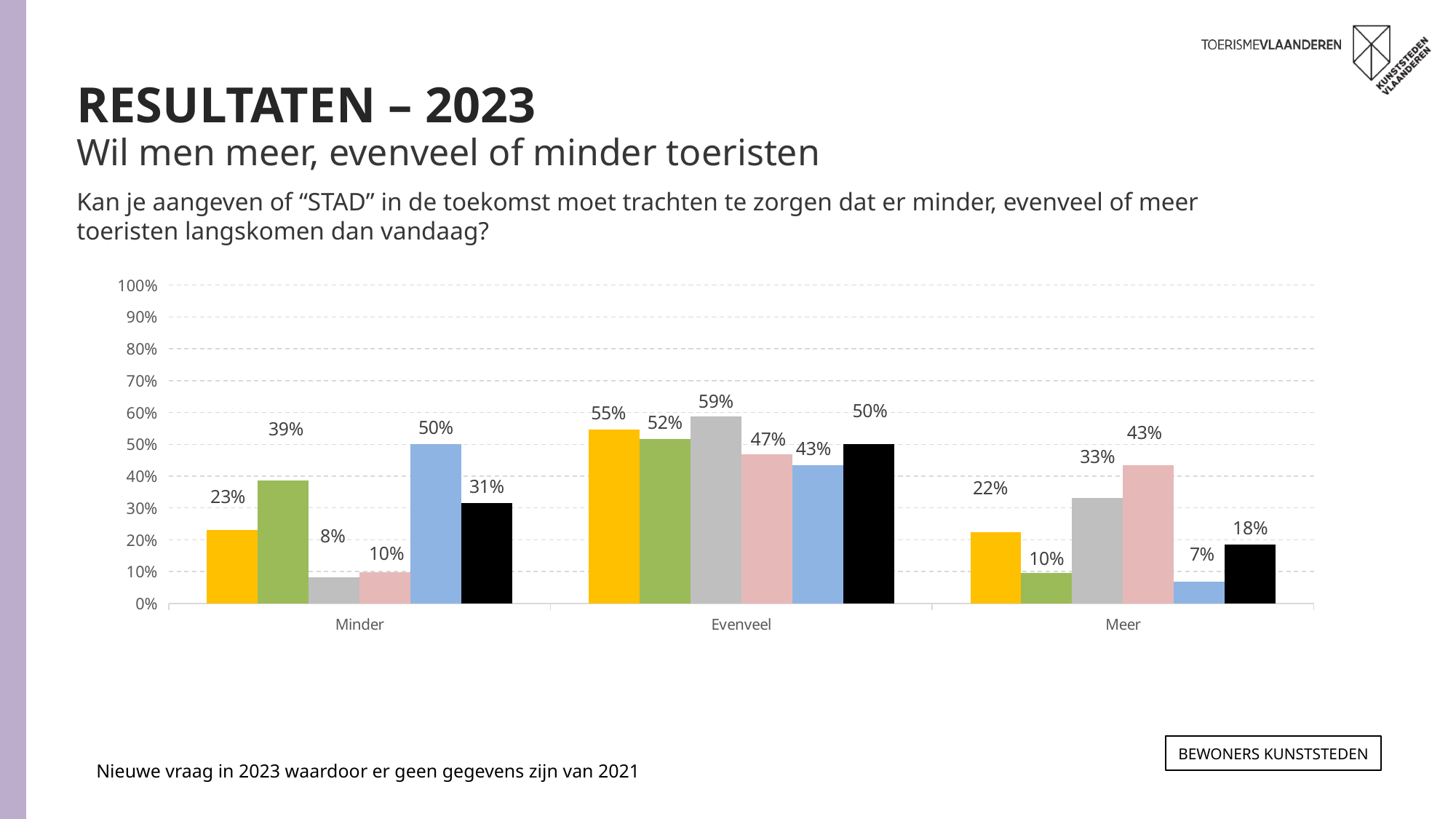
Which bar is the highest in the "Evenveel" group? The grey bar (59%) What is the value of the yellow bar for the category "Minder"? 23% In the "Meer" group, which is larger: the grey bar or the black bar? The grey bar Which bar is the lowest in the "Meer" group? The blue bar (7%) What is the value of the blue bar for the category "Minder"? 50% What is the highest value shown on the y axis? 100% How many bars are shown in each category group? 6 What is the value of the pink bar for the category "Meer"? 43% What is the value of the grey bar for the category "Evenveel"? 59% How many categories are shown on the x axis? 3 What is the difference between the blue bar and the yellow bar in the "Minder" group? 27 percentage points What kind of chart is shown on the slide? Bar chart